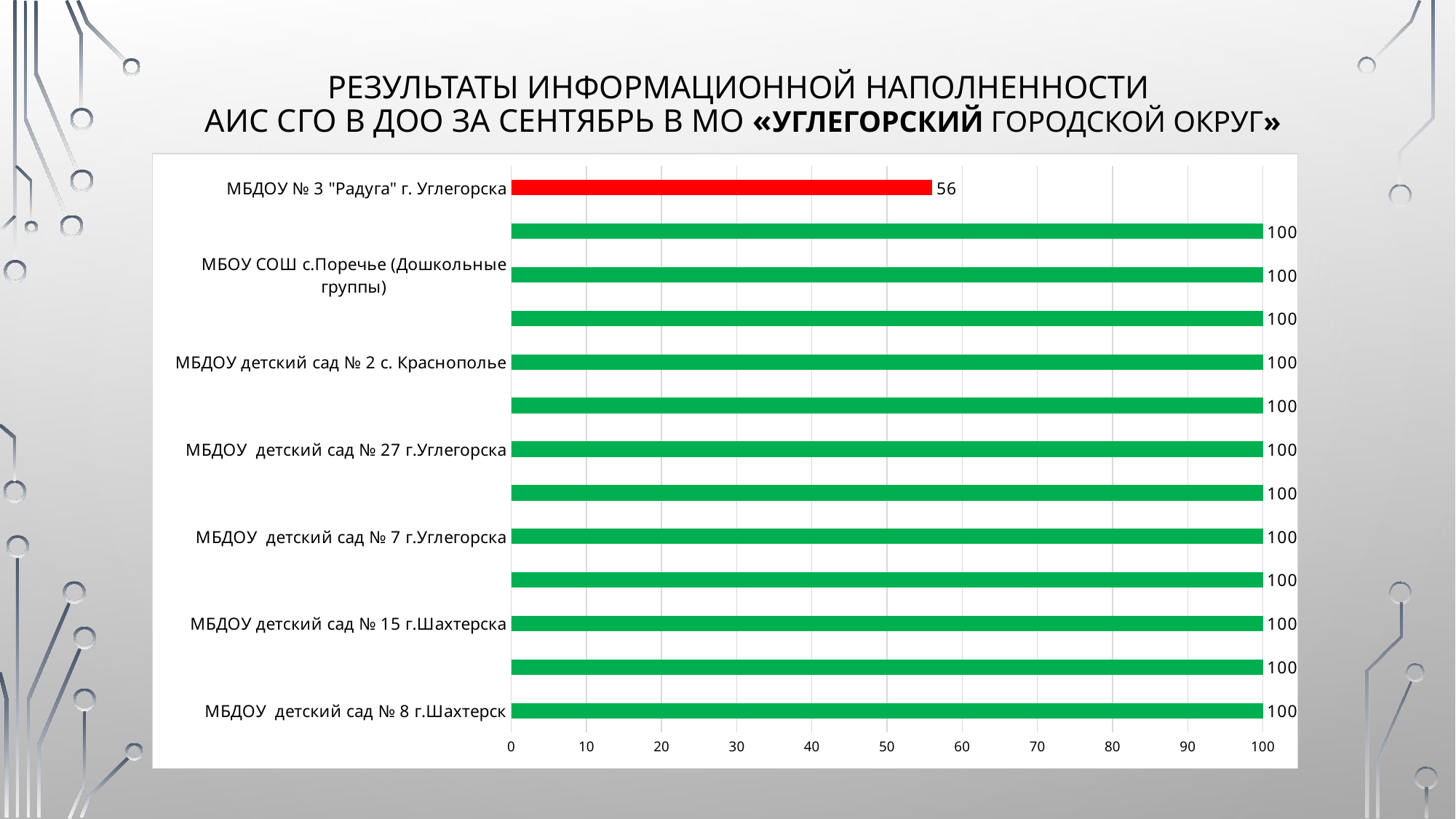
What is the value for МБДОУ № 3 "Радуга" г. Углегорска? 56 What is the value for МБДОУ детский сад № 8 г.Шахтерск? 100 How many bars are plotted in the chart? 13 Is the value for МБДОУ № 3 "Радуга" г. Углегорска greater or less than 60? less What kind of chart is shown on the slide? bar chart Which is larger: the value for МБДОУ детский сад № 7 г.Углегорска or the value for МБДОУ № 3 "Радуга" г. Углегорска? МБДОУ детский сад № 7 г.Углегорска What is the highest value shown on the horizontal axis? 100 Which category has the lowest value? МБДОУ № 3 "Радуга" г. Углегорска What colour is the bar for МБДОУ № 3 "Радуга" г. Углегорска? red What is the value for МБДОУ детский сад № 15 г.Шахтерска? 100 What is the value for МБДОУ детский сад № 2 с. Краснополье? 100 What is the difference between the value for МБДОУ детский сад № 27 г.Углегорска and the value for МБДОУ № 3 "Радуга" г. Углегорска? 44